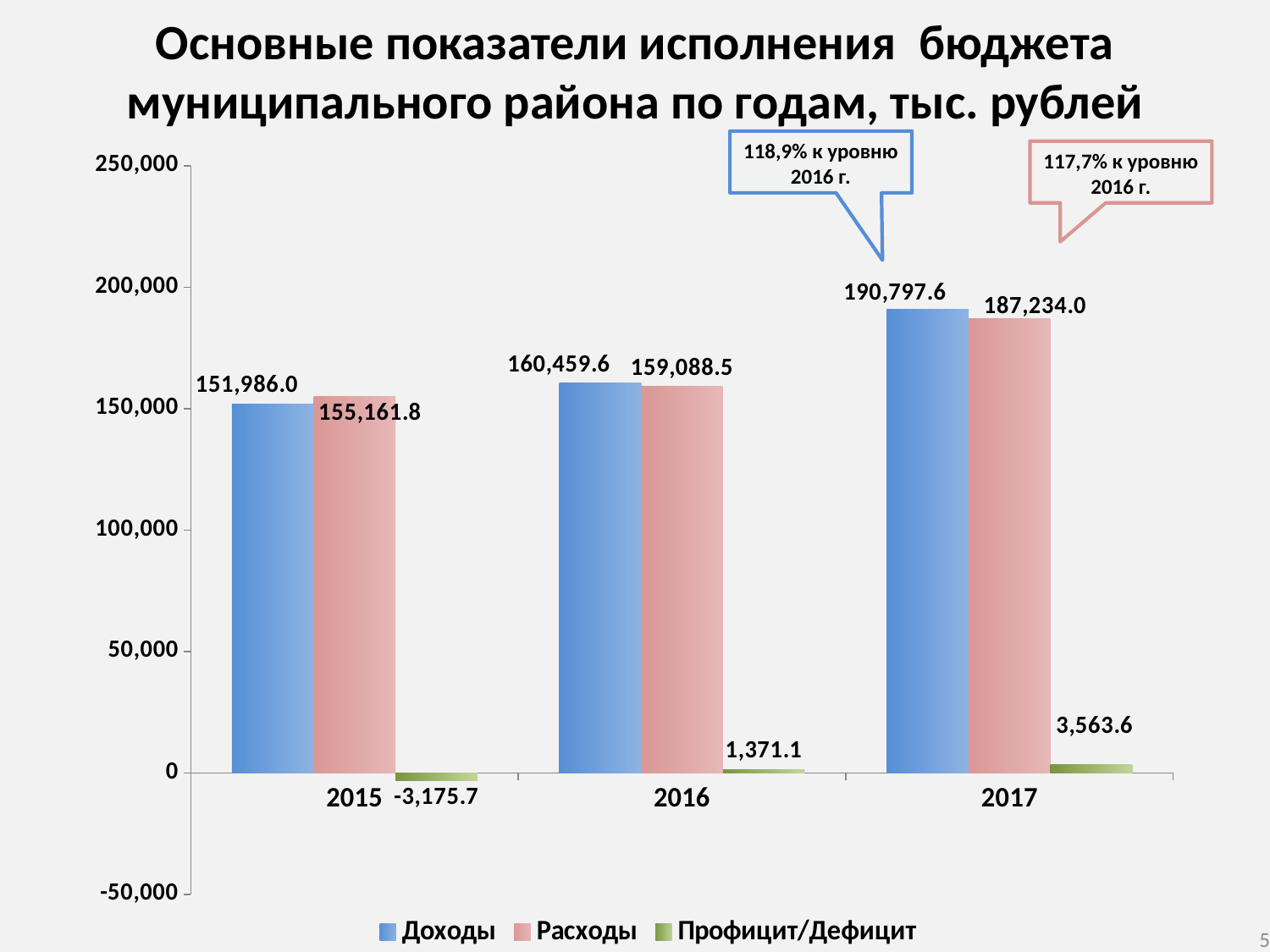
What type of chart is shown on the slide? Bar chart What is the value of Профицит/Дефицит for 2016? 1,371.1 What is the value of Доходы for 2017? 190,797.6 In which year is Профицит/Дефицит the lowest? 2015 How many series does the legend list? 3 What is the value of Расходы for 2015? 155,161.8 What is the value of Профицит/Дефицит for 2015? -3,175.7 In which year is Доходы the highest? 2017 By how much did Доходы increase from 2016 to 2017? 30,338.0 Do the Расходы values rise or fall from 2015 to 2017? Rise Which is larger in 2015, Доходы or Расходы? Расходы How many years are shown on the x axis? 3